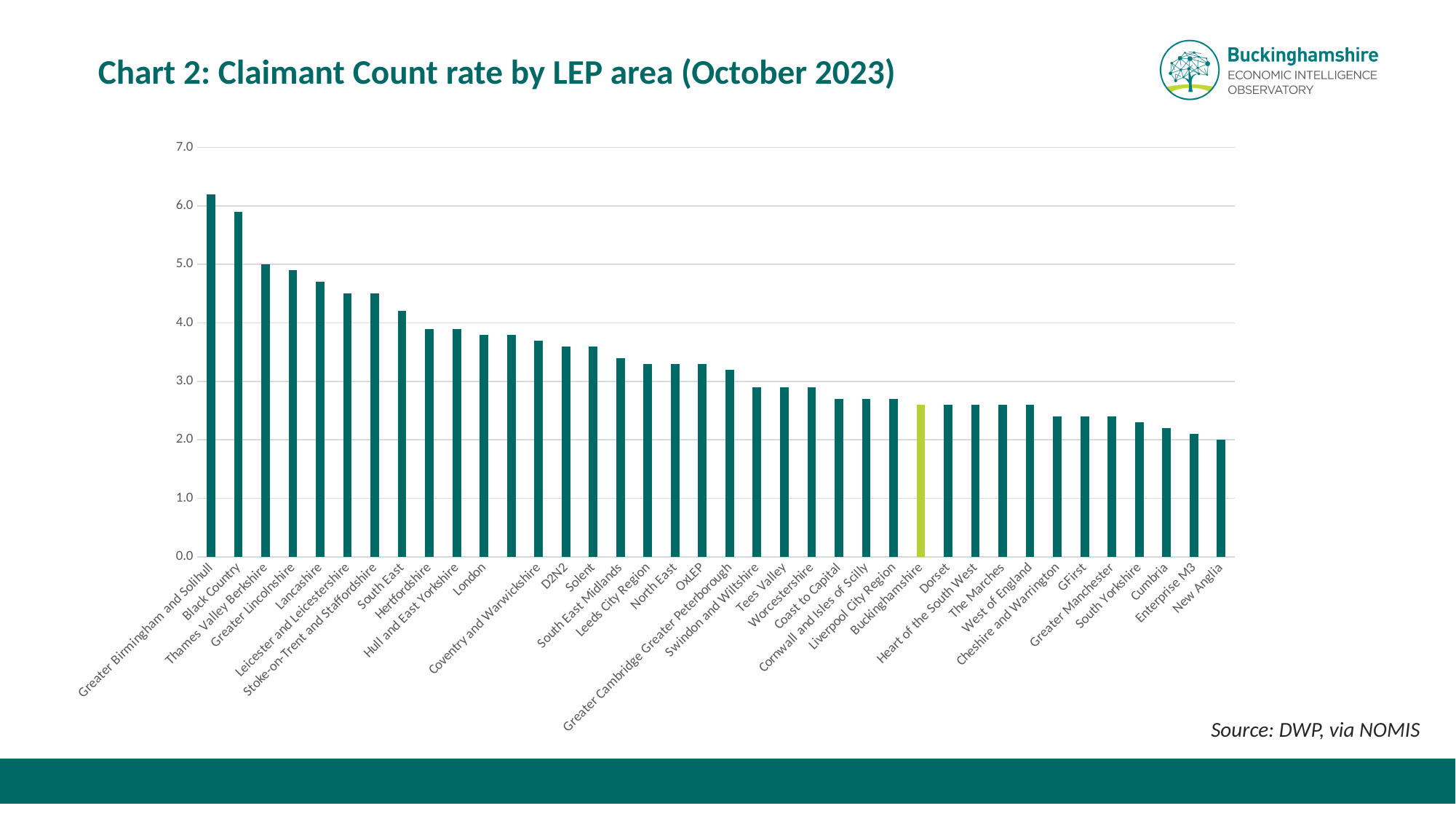
Is the value for Buckinghamshire greater or less than 3.0? less Which LEP area has the highest Claimant Count rate? Greater Birmingham and Solihull Which has the larger Claimant Count rate, Black Country or Lancashire? Black Country Which LEP area's bar is highlighted in a different (green) colour from the rest? Buckinghamshire Is the value for Lancashire greater or less than 4.0? greater Which LEP area has the lowest Claimant Count rate? New Anglia Is the value for London greater or less than 4.0? less What kind of chart is shown on the slide? bar chart Do the values rise or fall moving from left to right along the x axis? fall Which has the larger Claimant Count rate, London or Buckinghamshire? London How many LEP areas are shown on the chart? 37